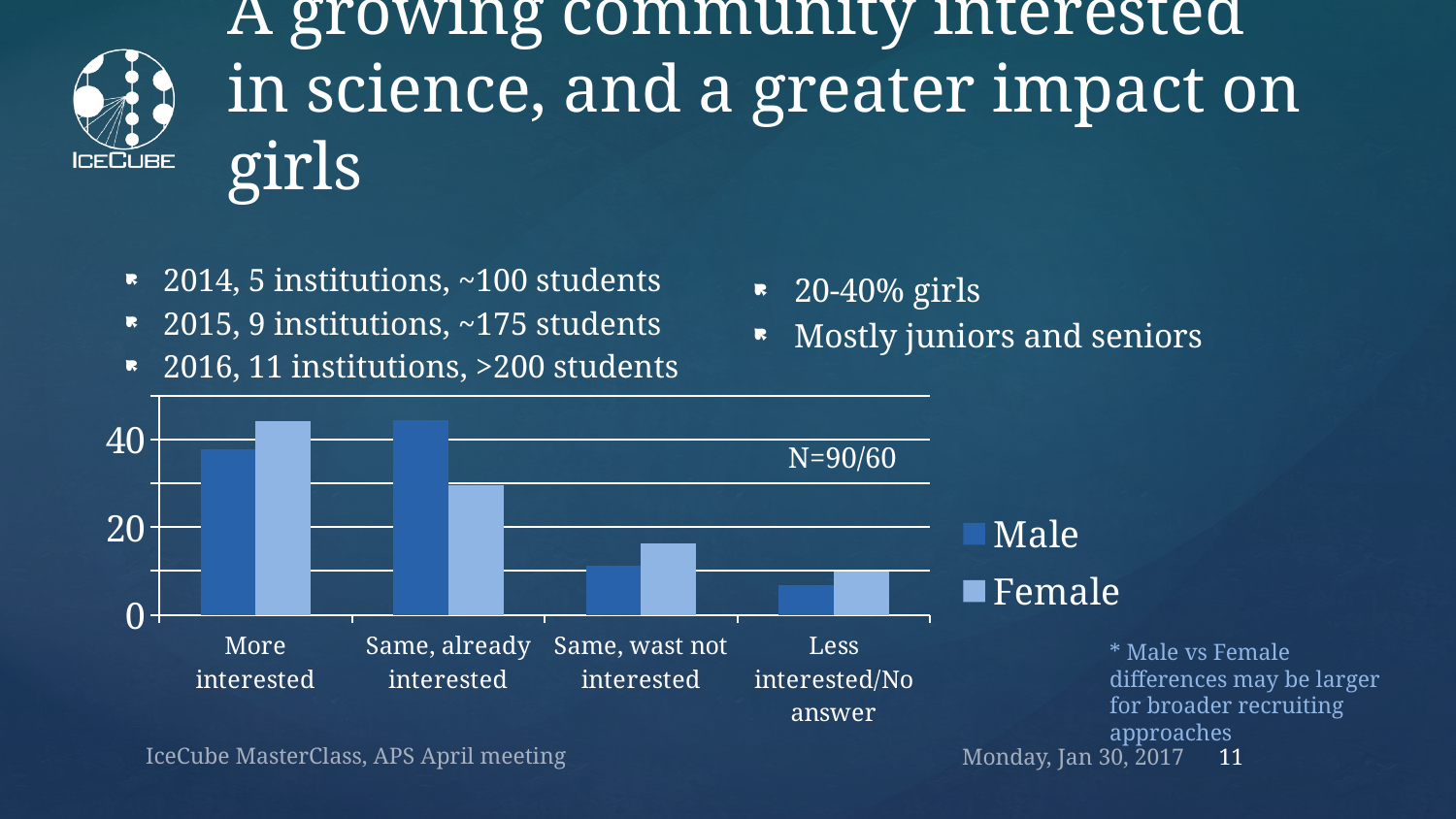
In the 'More interested' category, which series has the larger value, Male or Female? Female What kind of chart is shown on the slide? bar chart How many series does the chart's legend list? 2 Is the Male value for 'More interested' greater or less than 20? greater What sample size annotation is printed inside the chart area? N=90/60 In the 'Same, already interested' category, which series has the larger value, Male or Female? Male How many categories are shown along the x axis of the chart? 4 Is the Female value for 'Same, already interested' greater or less than 40? less Which category has the lowest value for the Male series? Less interested/No answer Which category has the lowest value for the Female series? Less interested/No answer Which category has the highest value for the Female series? More interested Which category has the highest value for the Male series? Same, already interested